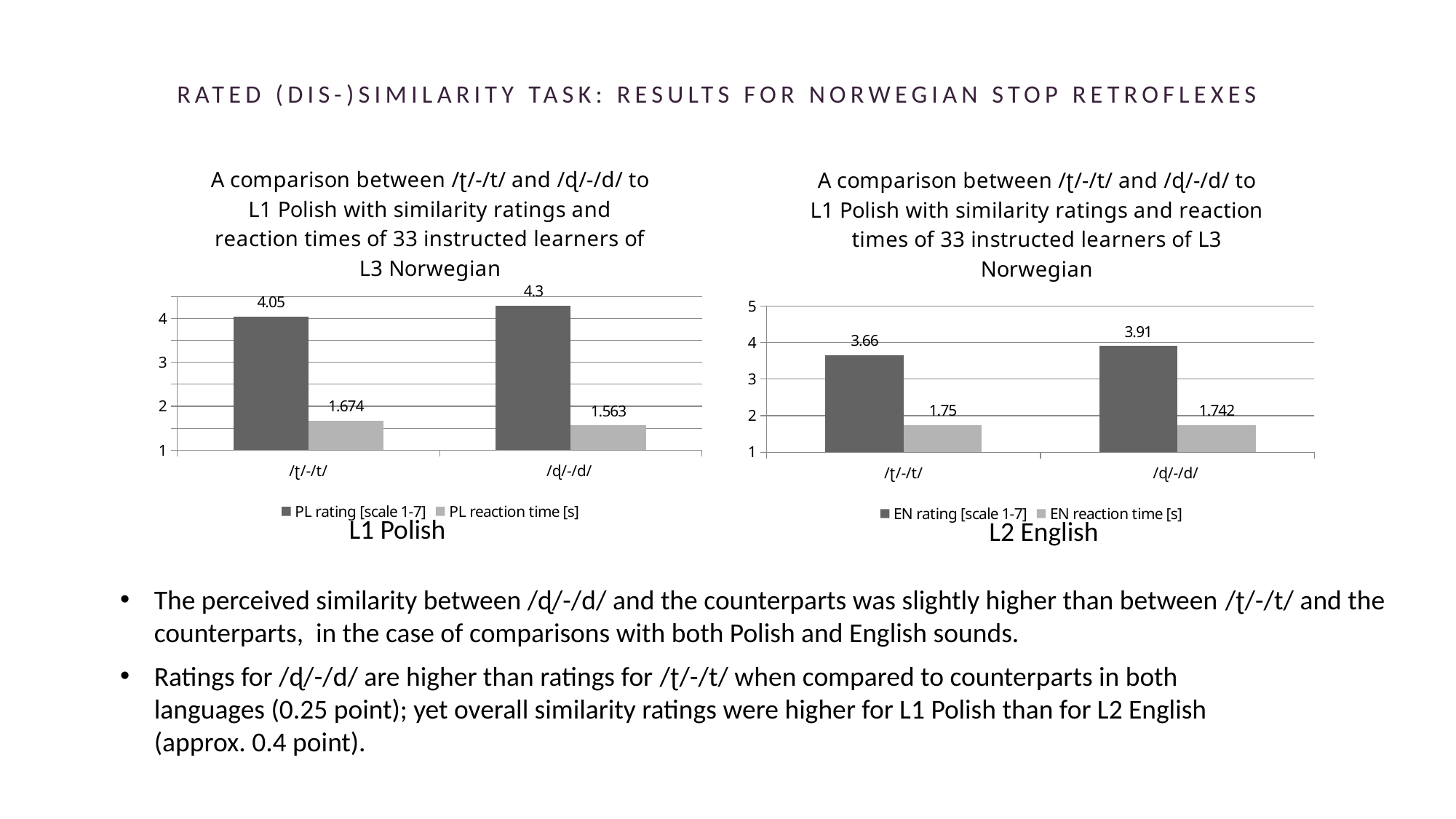
In the right chart (L2 English), which category has the lower EN rating? /ʈ/-/t/ In the right chart (L2 English), is the EN rating for /ʈ/-/t/ greater or less than 4? less How many series does the legend of the left chart (L1 Polish) list? 2 In the left chart (L1 Polish), what is the PL rating for /ʈ/-/t/? 4.05 In the left chart (L1 Polish), which category has the higher PL rating? /ɖ/-/d/ In the left chart (L1 Polish), what is the difference between the PL rating for /ɖ/-/d/ and the PL rating for /ʈ/-/t/? 0.25 What kind of chart is the right chart (L2 English)? bar chart In the right chart (L2 English), what is the EN rating for /ɖ/-/d/? 3.91 In the left chart (L1 Polish), is the PL reaction time for /ʈ/-/t/ larger or smaller than the PL reaction time for /ɖ/-/d/? larger In the left chart (L1 Polish), what is the PL reaction time for /ɖ/-/d/? 1.563 In the right chart (L2 English), what is the EN reaction time for /ʈ/-/t/? 1.75 In the right chart (L2 English), what is the difference between the EN rating for /ɖ/-/d/ and the EN rating for /ʈ/-/t/? 0.25